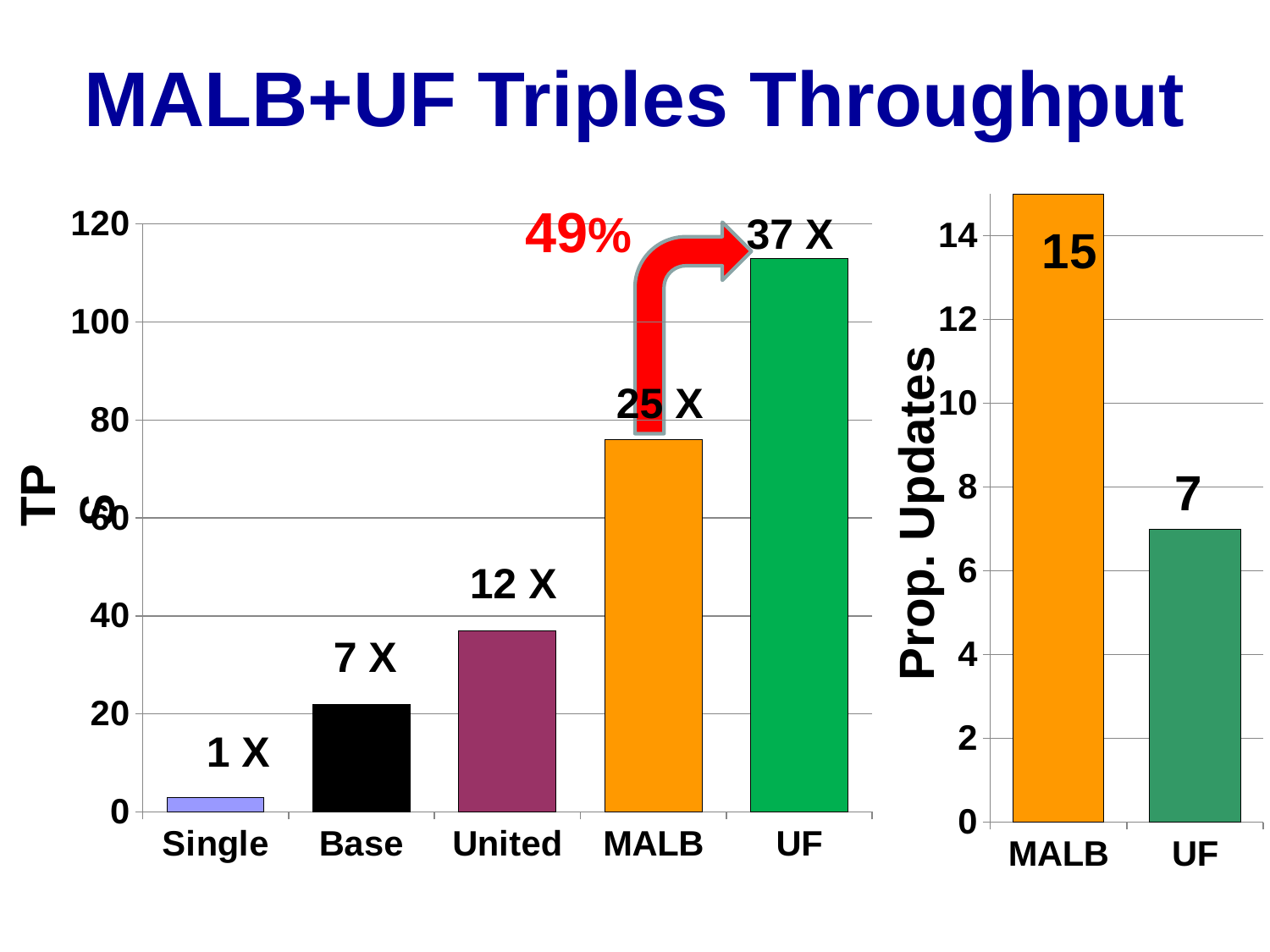
In the left chart (TP), do the bar values rise or fall from Single to UF? rise In the right chart (Prop. Updates), which is larger, MALB or UF? MALB In the left chart (TP), how many categories are shown on the x axis? 5 In the left chart (TP), which category has the lowest bar? Single What type of chart is the right chart (Prop. Updates)? bar chart In the left chart (TP), which category has the highest bar? UF In the left chart (TP), is the value for MALB greater or less than 60? greater In the left chart (TP), is the value for Base greater or less than 40? less In the left chart (TP), what is the data label shown above the MALB bar? 25 X In the right chart (Prop. Updates), what is the difference between the MALB and UF values? 8 In the left chart (TP), what is the data label shown above the UF bar? 37 X In the right chart (Prop. Updates), what is the value for MALB? 15